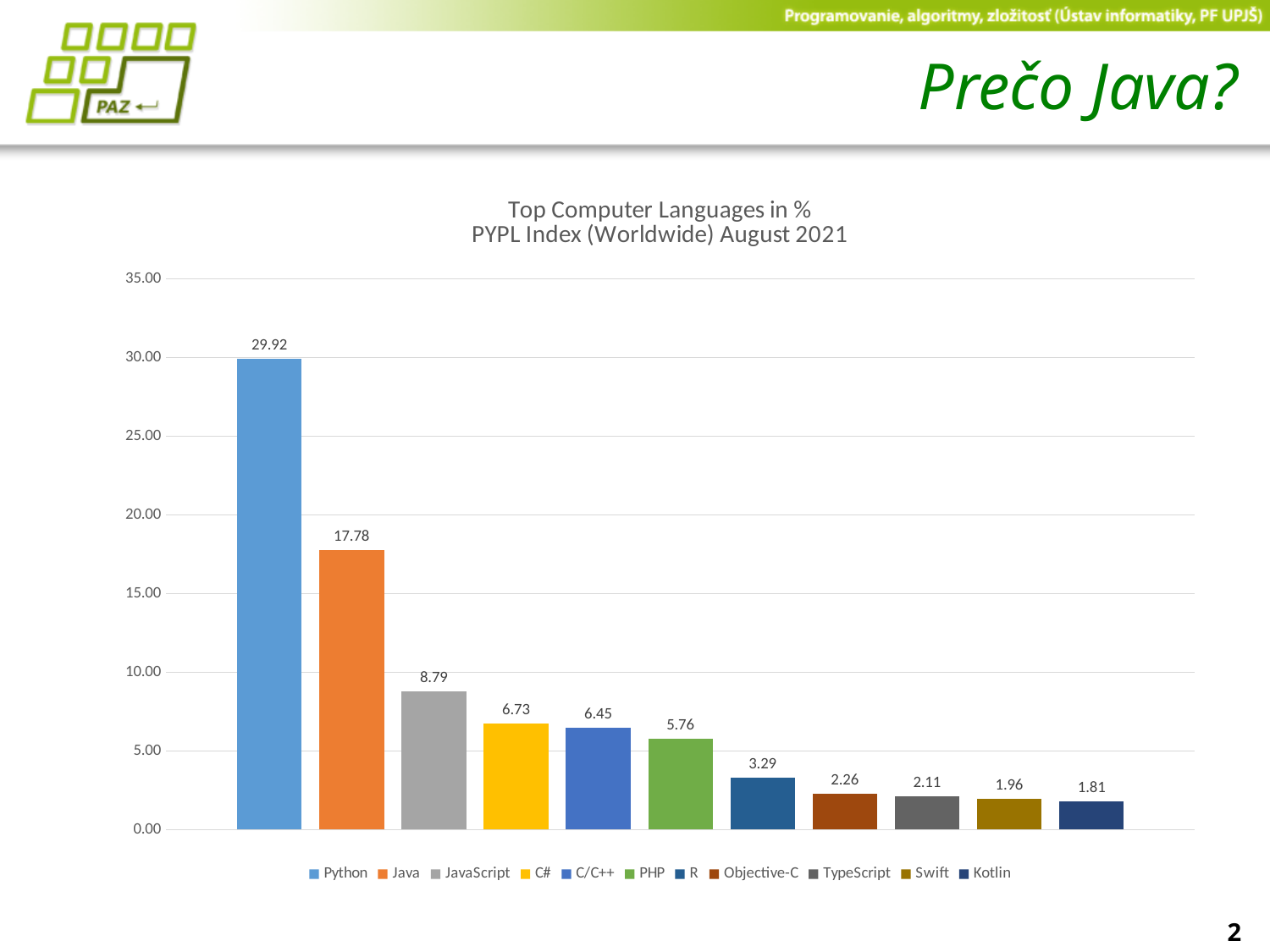
What is the difference between the values for Python and Java? 12.14 Which has a larger value, C# or PHP? C# Which language has the lowest value? Kotlin What is the title of the chart? Top Computer Languages in % PYPL Index (Worldwide) August 2021 What kind of chart is shown on the slide? bar chart What is the value for Java? 17.78 How many entries does the legend list? 11 What is the value for Python? 29.92 What is the value for TypeScript? 2.11 How many languages are shown in the chart? 11 Which language has the highest value? Python Is the value for JavaScript greater or less than 10.00? less